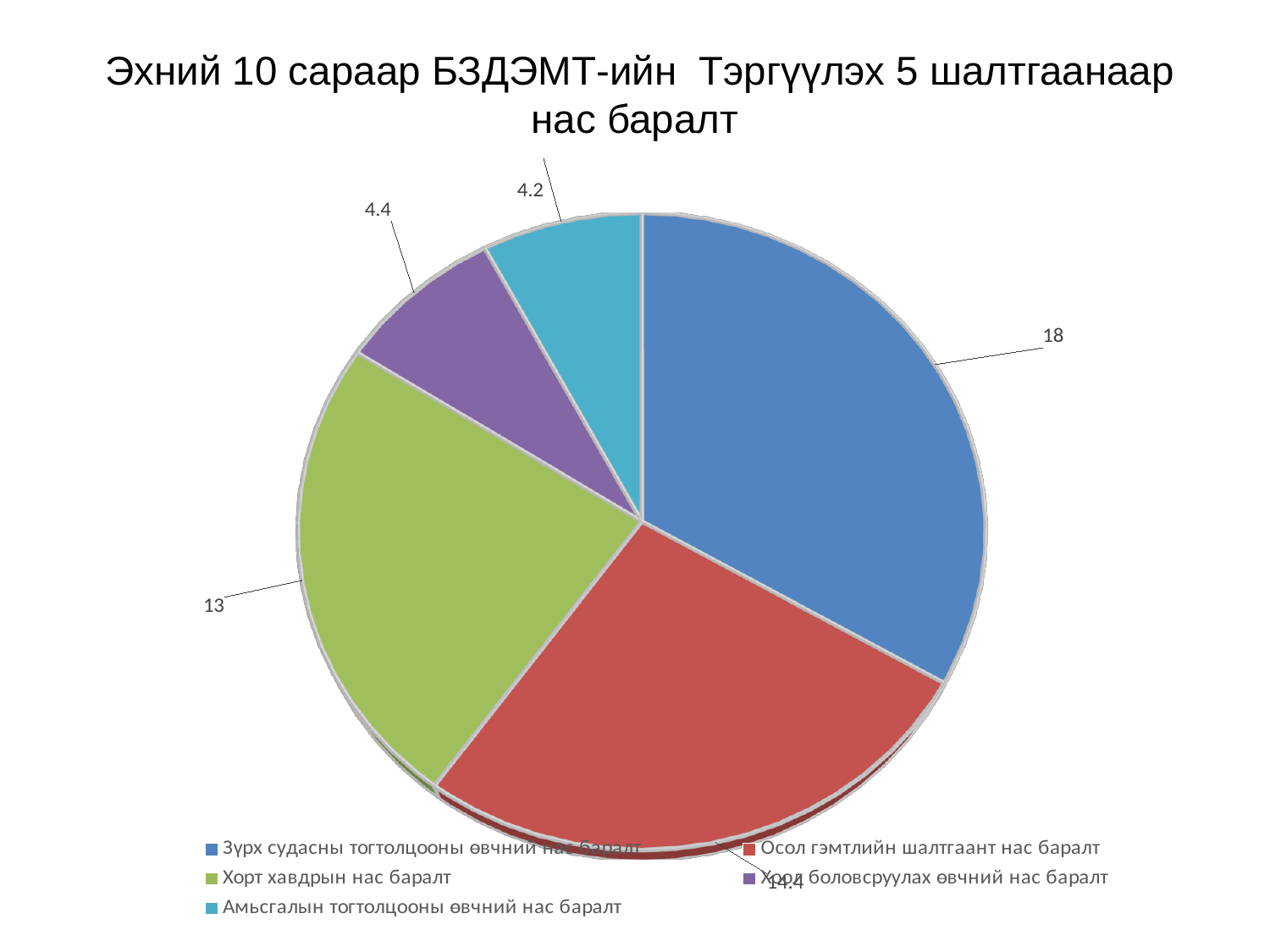
What is the value for Осол гэмтлийн шалтгаант нас баралт? 14.4 What colour is the slice for Хорт хавдрын нас баралт? green Which is larger, the value for Осол гэмтлийн шалтгаант нас баралт or the value for Хорт хавдрын нас баралт? Осол гэмтлийн шалтгаант нас баралт What is the value of the purple slice? 4.4 What is the value for Зүрх судасны тогтолцооны өвчний нас баралт? 18 What is the difference between the values for Зүрх судасны тогтолцооны өвчний нас баралт and Хорт хавдрын нас баралт? 5 What is the value for Хорт хавдрын нас баралт? 13 Which category has the largest slice? Зүрх судасны тогтолцооны өвчний нас баралт How many slices does the pie chart have? 5 What is the value for Амьсгалын тогтолцооны өвчний нас баралт? 4.2 What kind of chart is shown on the slide? pie chart Which category has the smallest slice? Амьсгалын тогтолцооны өвчний нас баралт